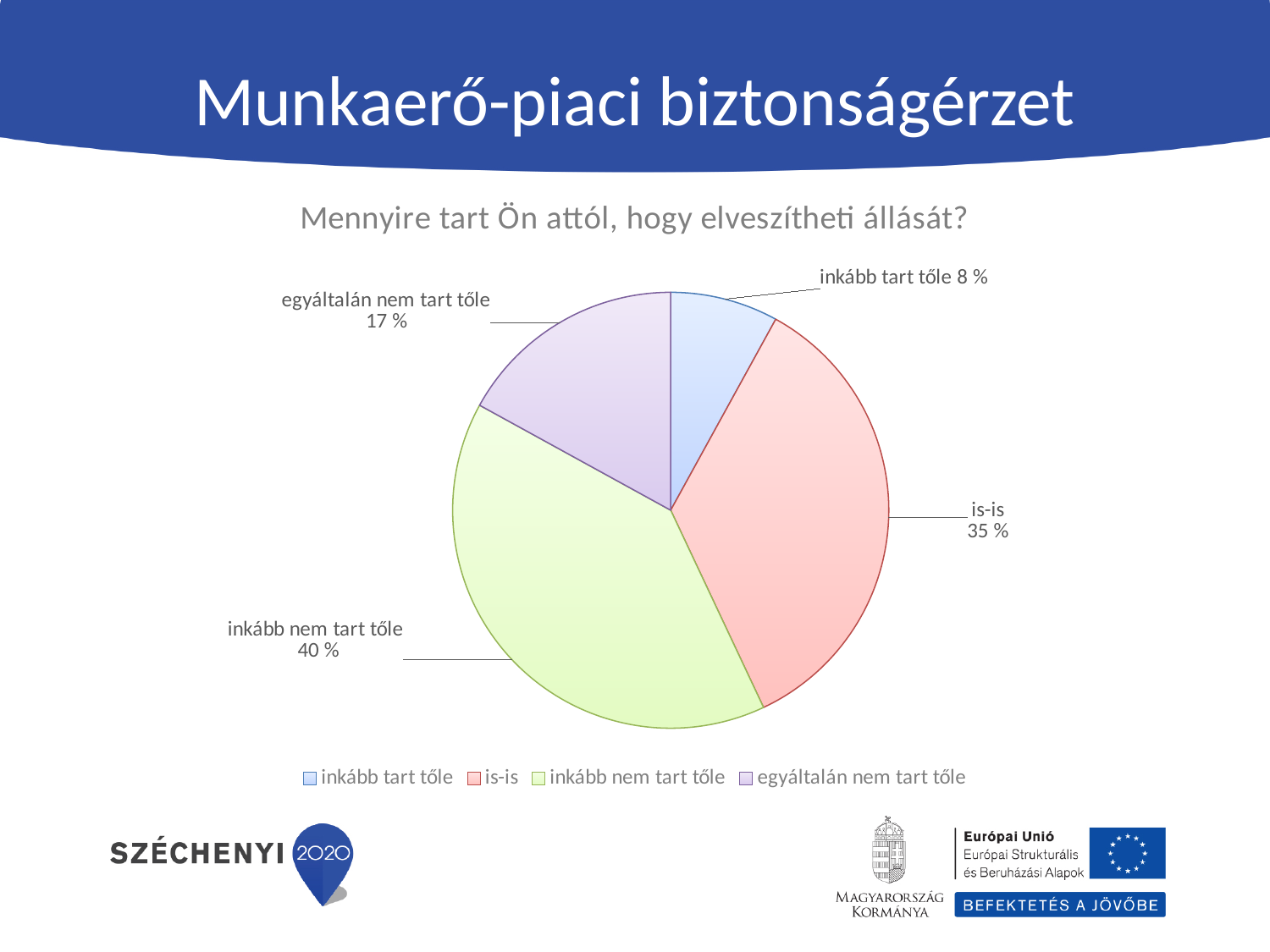
Which is larger, the value for "egyáltalán nem tart tőle" or the value for "inkább tart tőle"? egyáltalán nem tart tőle What is the value for "inkább tart tőle"? 8 % What is the difference between the values for "inkább nem tart tőle" and "is-is"? 5 % How many slices does the pie chart have? 4 What question is shown as the chart title? Mennyire tart Ön attól, hogy elveszítheti állását? What is the value for "is-is"? 35 % What is the value for "egyáltalán nem tart tőle"? 17 % How many entries does the legend list? 4 Which category has the largest share of the pie? inkább nem tart tőle What is the value for "inkább nem tart tőle"? 40 % Which category has the smallest share of the pie? inkább tart tőle What type of chart is shown on the slide? pie chart